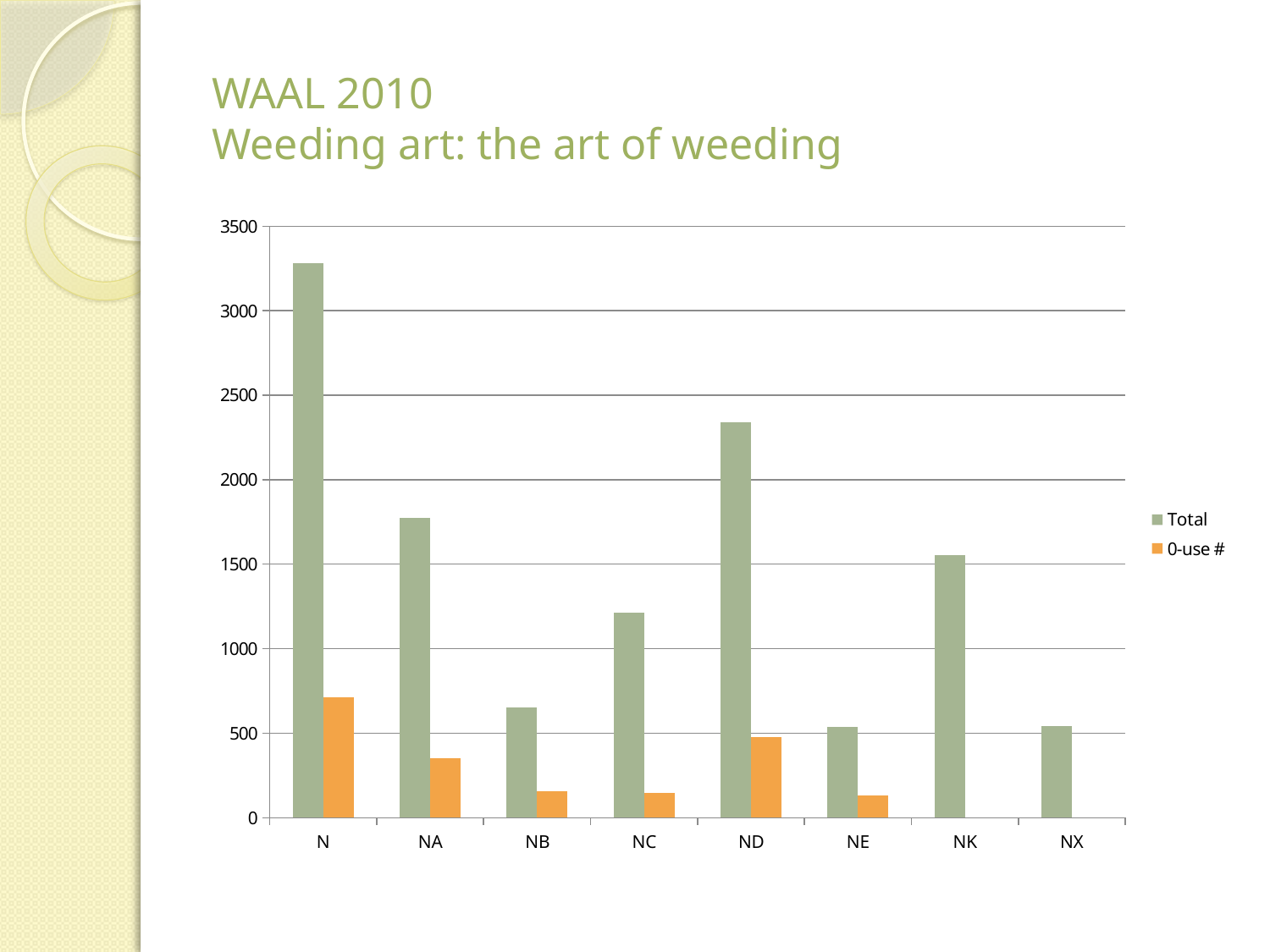
Which category has the highest Total value? N Is the Total value for ND greater or less than 2500? less How many series does the chart's legend list? 2 Is the Total value for NK greater or less than 1000? greater Is the 0-use # value for N greater or less than 500? greater What are the two series named in the chart's legend? Total and 0-use # Which is larger, the Total value for NA or the Total value for NC? NA What kind of chart is shown on the slide? bar chart Which category has the highest 0-use # value? N How many categories are shown on the x axis of the chart? 8 Which is larger, the Total value for ND or the Total value for NK? ND